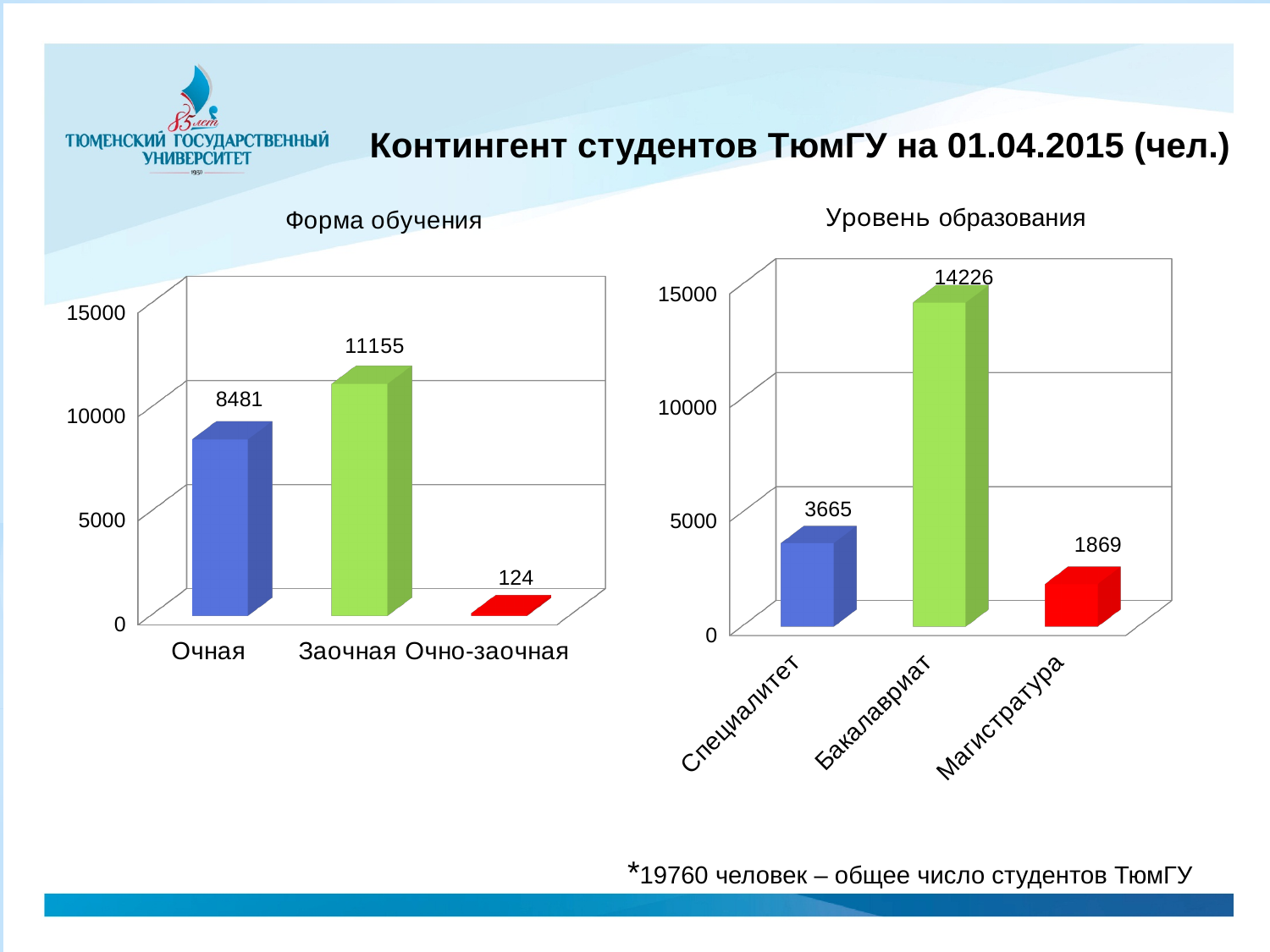
In the "Форма обучения" chart, what is the value for Заочная? 11155 In the "Форма обучения" chart, what is the difference between Заочная and Очная? 2674 In the "Форма обучения" chart, how many categories are shown? 3 What kind of chart is the "Уровень образования" chart? Bar chart What is the title of the slide? Контингент студентов ТюмГУ на 01.04.2015 (чел.) In the "Уровень образования" chart, which is larger, Специалитет or Магистратура? Специалитет In the "Форма обучения" chart, which category has the lowest value? Очно-заочная In the "Уровень образования" chart, which category has the highest value? Бакалавриат In the "Уровень образования" chart, what is the difference between Специалитет and Магистратура? 1796 In the "Форма обучения" chart, what is the value for Очная? 8481 In the "Уровень образования" chart, what is the value for Магистратура? 1869 In the "Уровень образования" chart, what is the value for Бакалавриат? 14226